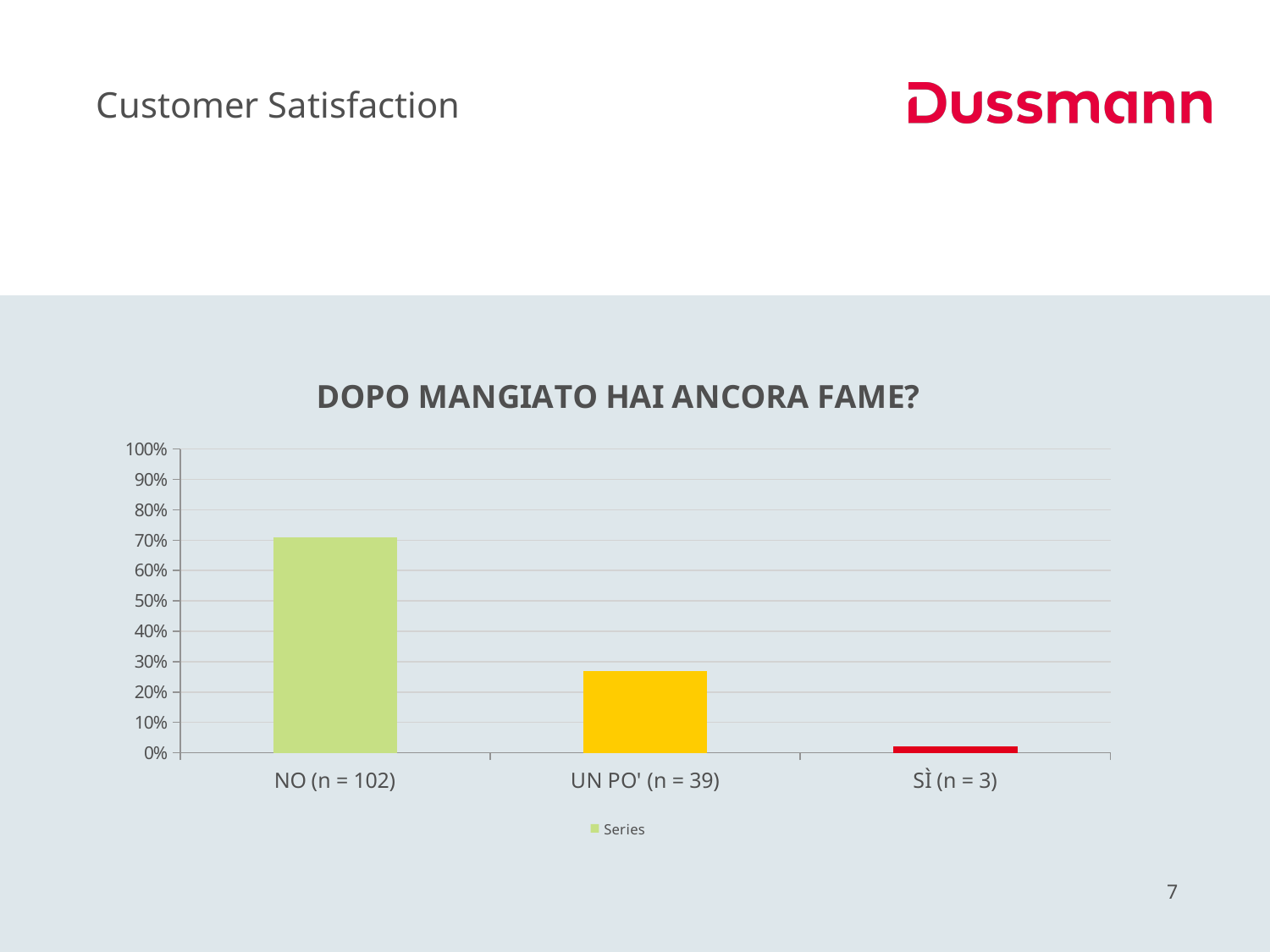
Which category has the lowest value? SÌ (n = 3) Which category has the highest value? NO (n = 102) Do the values rise or fall from left to right along the x axis? fall Which is larger, the value for NO (n = 102) or the value for UN PO' (n = 39)? NO (n = 102) Is the value for NO (n = 102) greater or less than 60%? greater What kind of chart is shown on the slide? bar chart What is the title of the chart? DOPO MANGIATO HAI ANCORA FAME? How many series does the legend list? 1 Is the value for UN PO' (n = 39) greater or less than 30%? less How many categories are shown on the x axis of the chart? 3 What colour is the bar for SÌ (n = 3)? red Is the value for SÌ (n = 3) greater or less than 10%? less